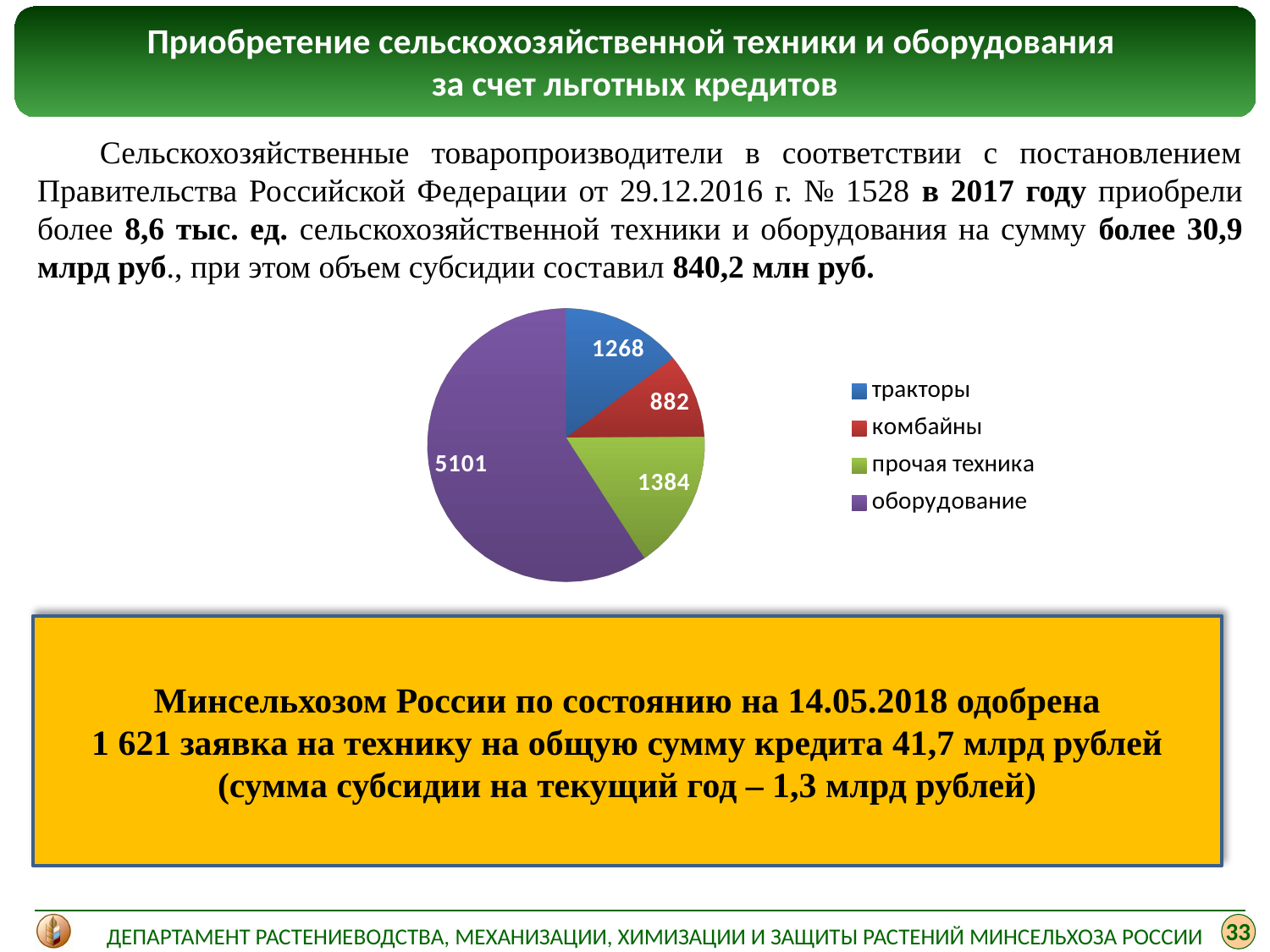
What is the value for оборудование in the pie chart? 5101 What is the value for комбайны in the pie chart? 882 Which is larger, the value for прочая техника or the value for тракторы? прочая техника Which category has the largest slice in the pie chart? оборудование How many slices does the pie chart have? 4 What is the value for тракторы in the pie chart? 1268 Which category has the smallest slice in the pie chart? комбайны What is the value for прочая техника in the pie chart? 1384 What is the difference between the values for оборудование and тракторы? 3833 What is the total of all four slices in the pie chart? 8635 Which legend entry is shown in purple? оборудование What kind of chart is shown on the slide? pie chart